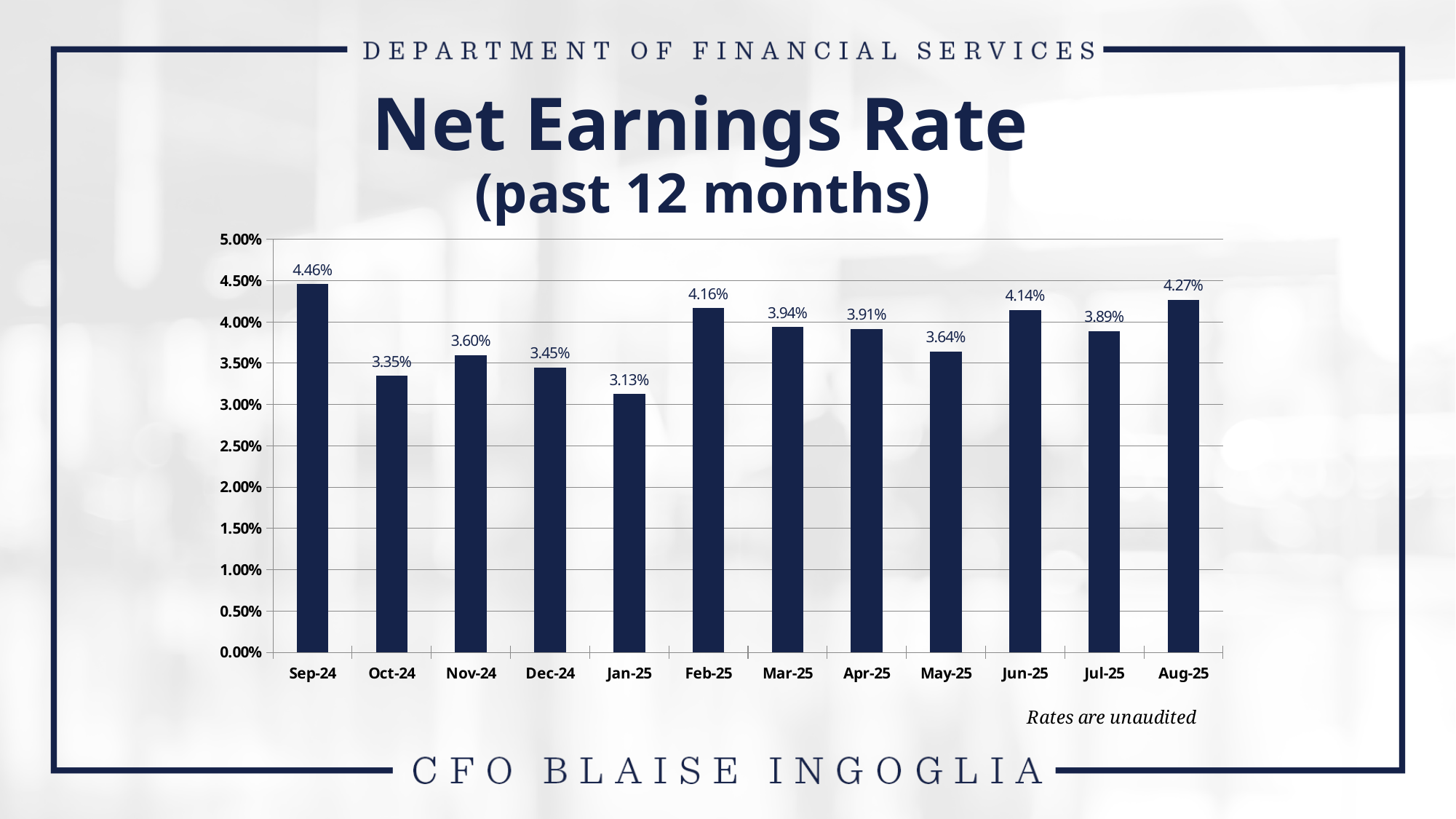
Which month has the lowest net earnings rate? Jan-25 What is the net earnings rate for Sep-24? 4.46% What is the difference between the net earnings rate for Aug-25 and Jul-25? 0.38% What is the net earnings rate for Jan-25? 3.13% What is the net earnings rate for Aug-25? 4.27% What kind of chart is shown on the slide? bar chart Which month has the highest net earnings rate? Sep-24 How many months are shown on the chart? 12 Which is larger, the net earnings rate for Feb-25 or Jun-25? Feb-25 What is the title of the chart? Net Earnings Rate (past 12 months) Does the net earnings rate rise or fall from Sep-24 to Jan-25? fall Is the net earnings rate for Oct-24 greater or less than 3.50%? less